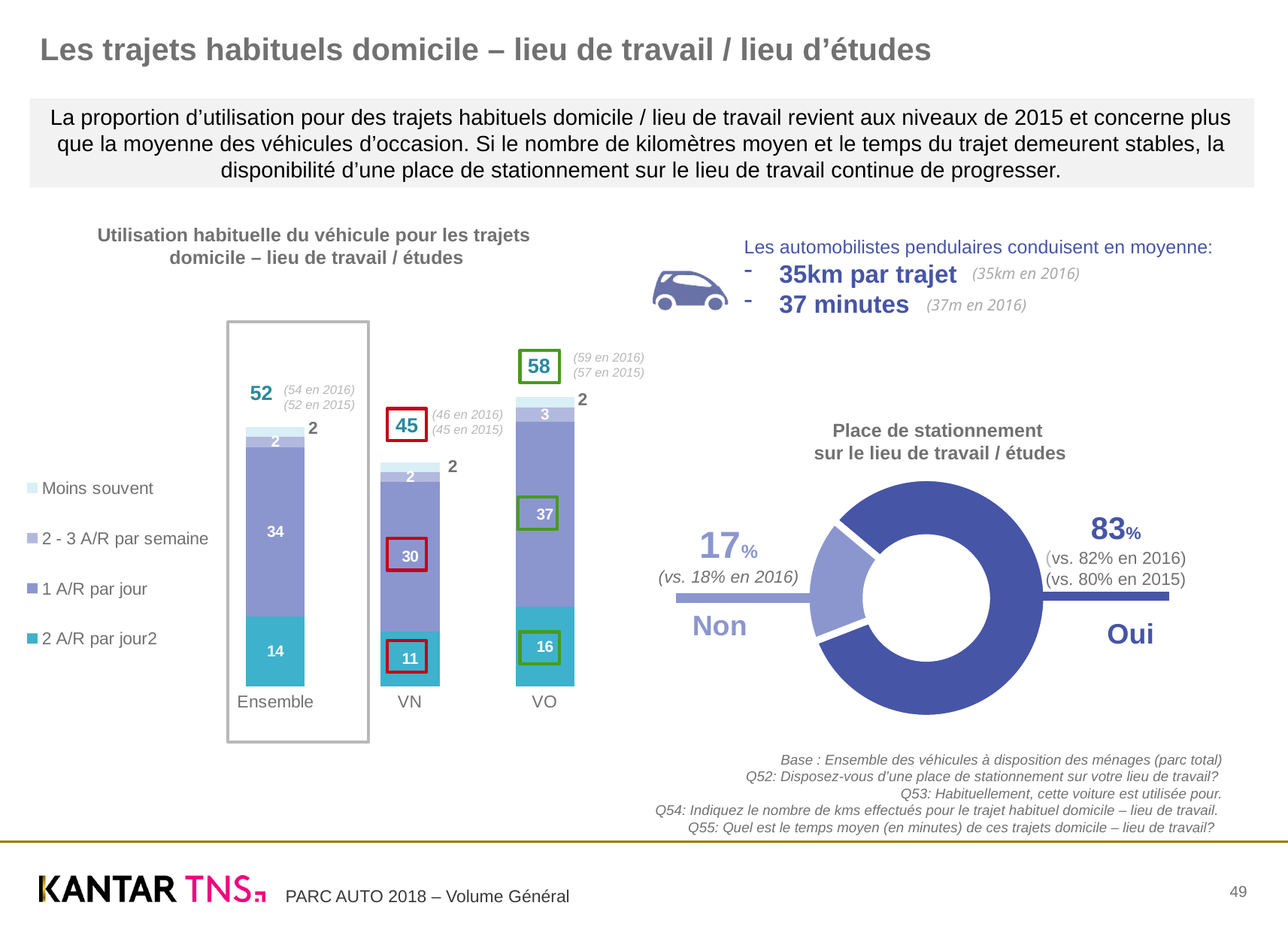
How many series does the legend of the stacked bar chart on the left list? 4 In the stacked bar chart on the left, is the '2 A/R par jour' value larger for Ensemble or for VN? Ensemble In the stacked bar chart on the left, which category has the lowest total? VN In the 'Place de stationnement sur le lieu de travail / études' chart, what share is 'Oui'? 83% In the stacked bar chart on the left, what is the total shown above the VN bar? 45 In the stacked bar chart on the left, which category has the highest total? VO In the stacked bar chart on the left, what is the value for '1 A/R par jour' for Ensemble? 34 In the stacked bar chart on the left, what is the difference between the '1 A/R par jour' values for VO and VN? 7 What kind of chart is 'Place de stationnement sur le lieu de travail / études'? Donut (pie) chart How many categories are shown on the x axis of the stacked bar chart on the left? 3 In the stacked bar chart on the left, what is the value for '2 A/R par jour' for VO? 16 In the 'Place de stationnement sur le lieu de travail / études' chart, what share is 'Non'? 17%